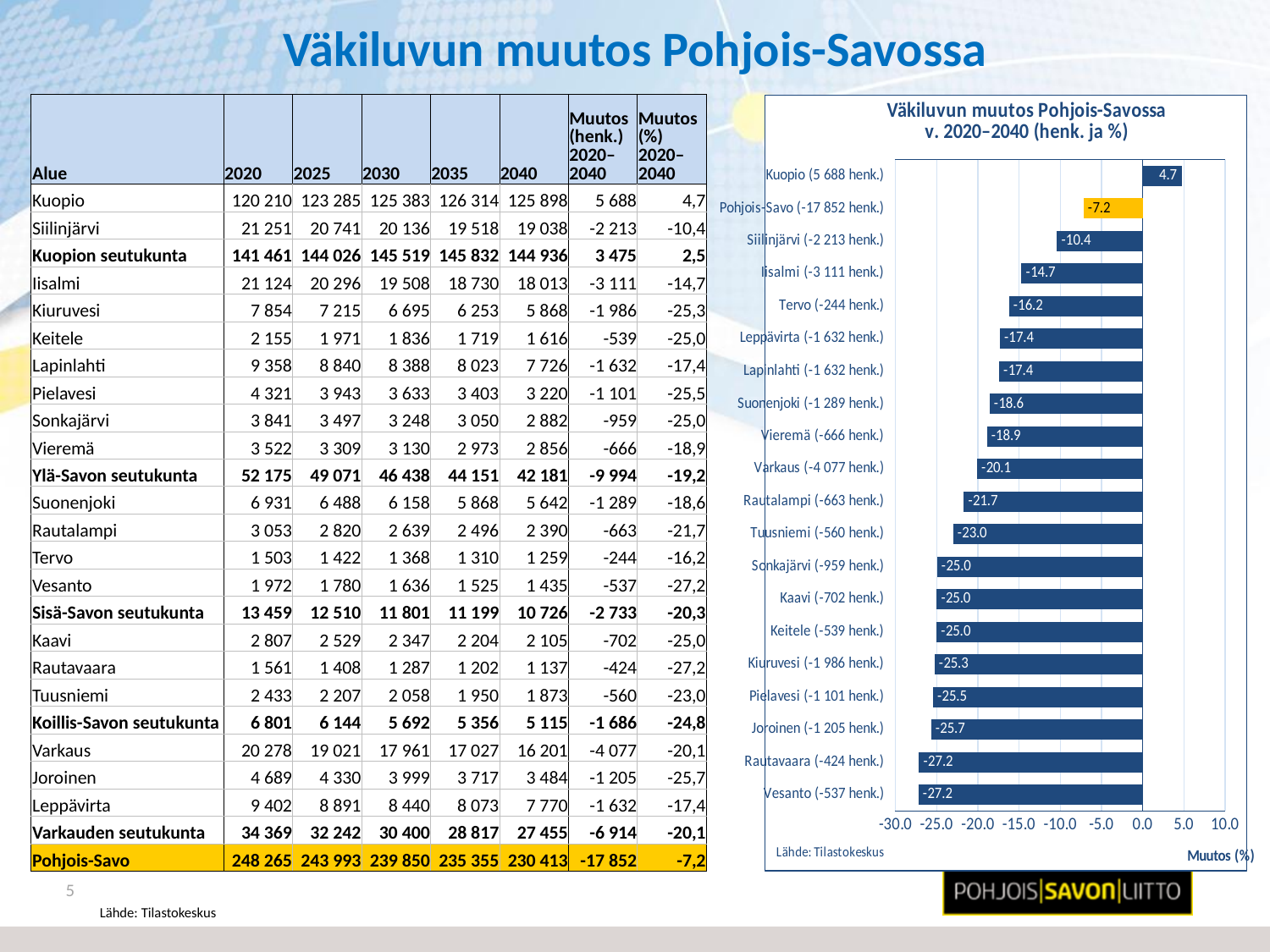
How many categories are plotted in the chart? 20 Which category has the highest value in the chart? Kuopio What kind of chart is shown on the right side of the slide? bar chart In the chart, which has the larger value, Iisalmi or Varkaus? Iisalmi What is the label of the horizontal axis of the chart? Muutos (%) In the chart, what is the value for Pohjois-Savo? -7.2 In the chart, is the value for Rautalampi greater or less than -20.0? less In the chart, what is the value for Varkaus? -20.1 In the chart, what is the difference between the values for Kuopio and Siilinjärvi? 15.1 In the chart, what is the value for Kuopio? 4.7 In the chart, what is the value for Tuusniemi? -23.0 What is the title of the chart? Väkiluvun muutos Pohjois-Savossa v. 2020–2040 (henk. ja %)